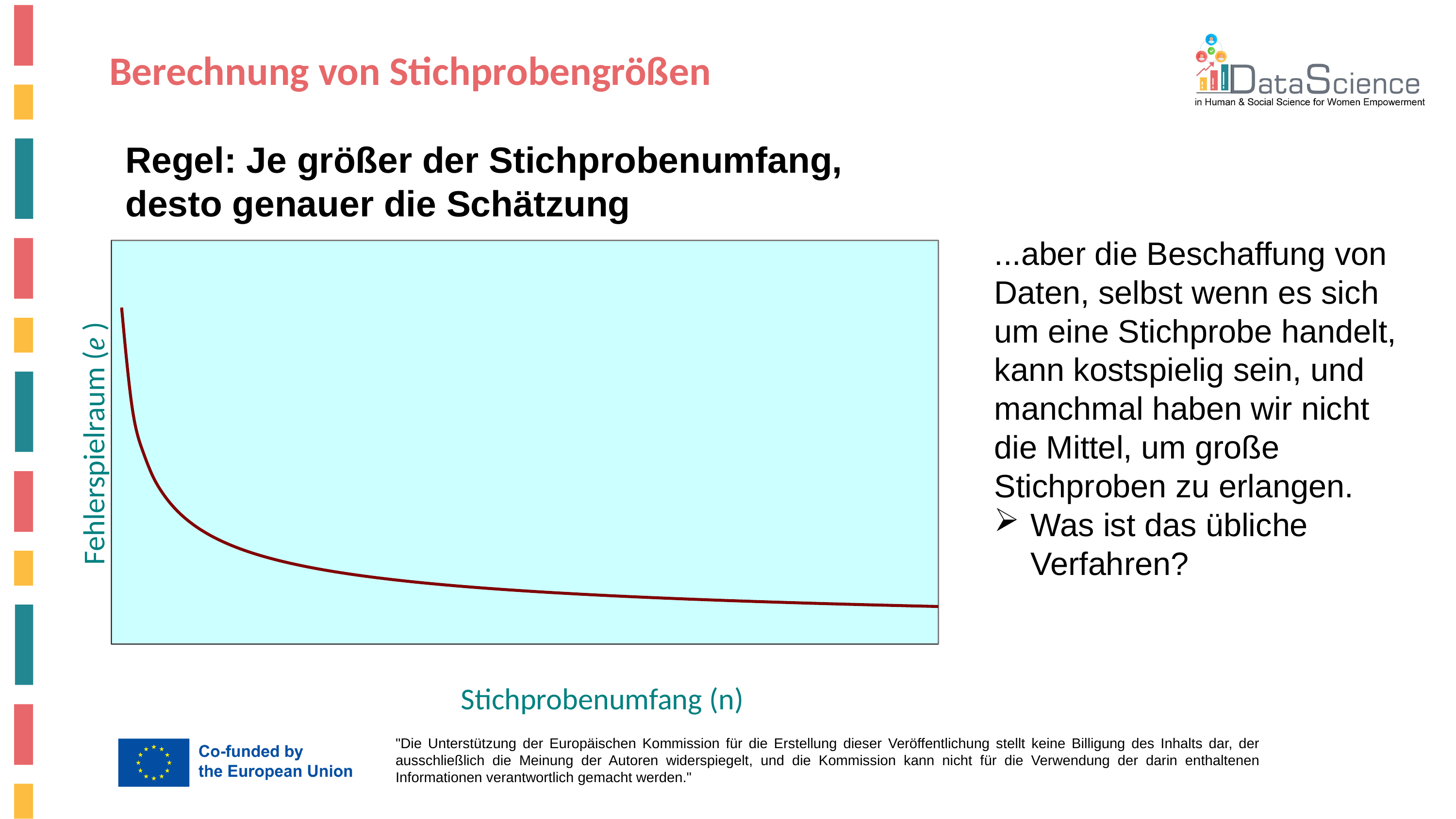
What kind of chart is shown on the slide? line chart Does the plotted curve rise or fall as the sample size (n) increases along the x axis? fall What is the label of the y axis of the chart? Fehlerspielraum (e) What is the label of the x axis of the chart? Stichprobenumfang (n) How many lines are plotted in the chart? 1 Is the margin of error (Fehlerspielraum) larger at the left end or the right end of the curve? left end